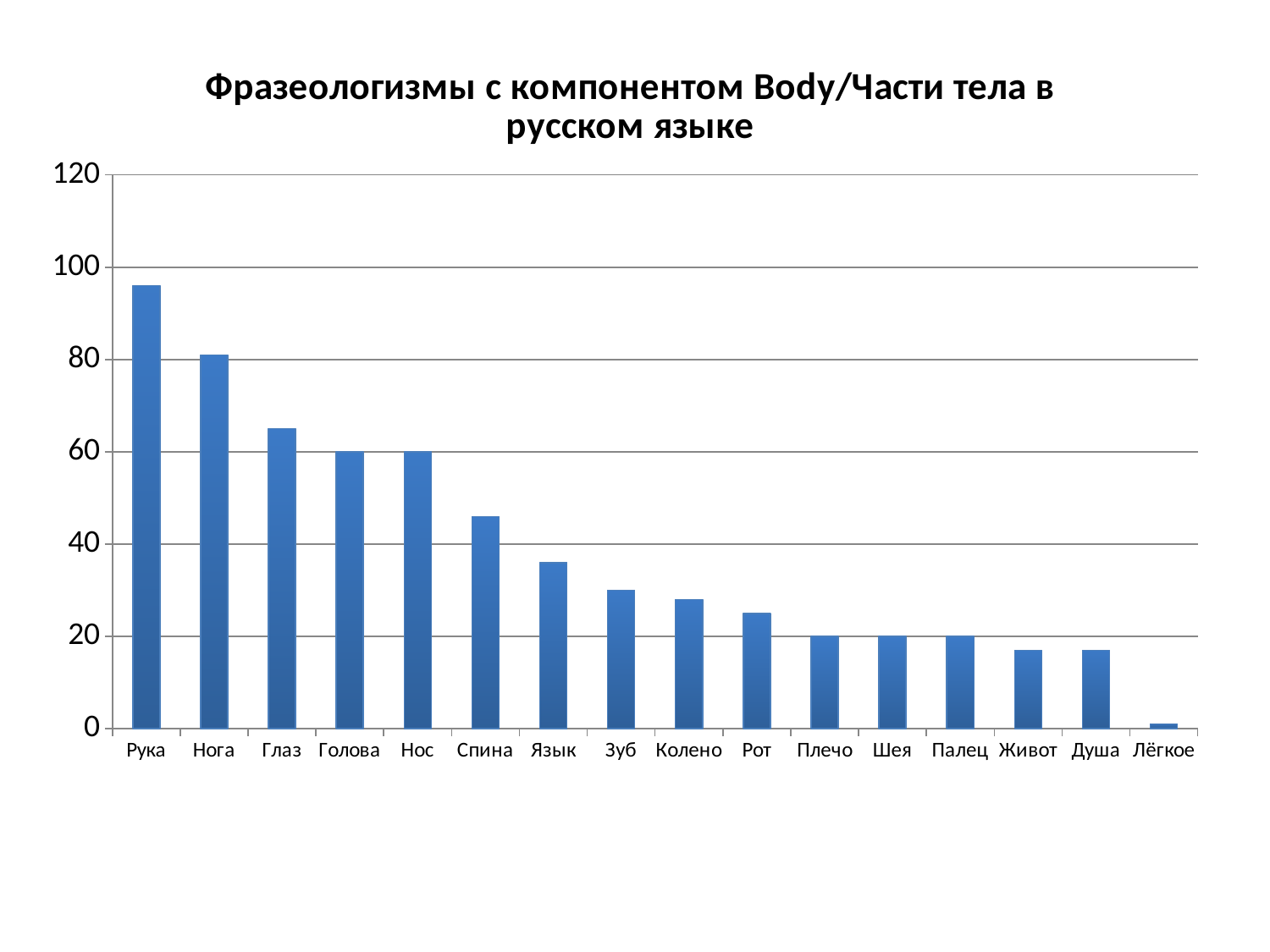
Do the values rise or fall from left to right along the x axis? fall What kind of chart is shown on the slide? bar chart What is the value for Плечо? 20 Is the value for Рот greater or less than 40? less Is the value for Рука greater or less than 80? greater Which is larger, the value for Нога or the value for Глаз? Нога What is the difference between the values for Нос and Шея? 40 Which category has the lowest value? Лёгкое Is the value for Спина greater or less than 40? greater How many categories are shown on the x axis? 16 What is the value for Голова? 60 Which category has the highest value? Рука